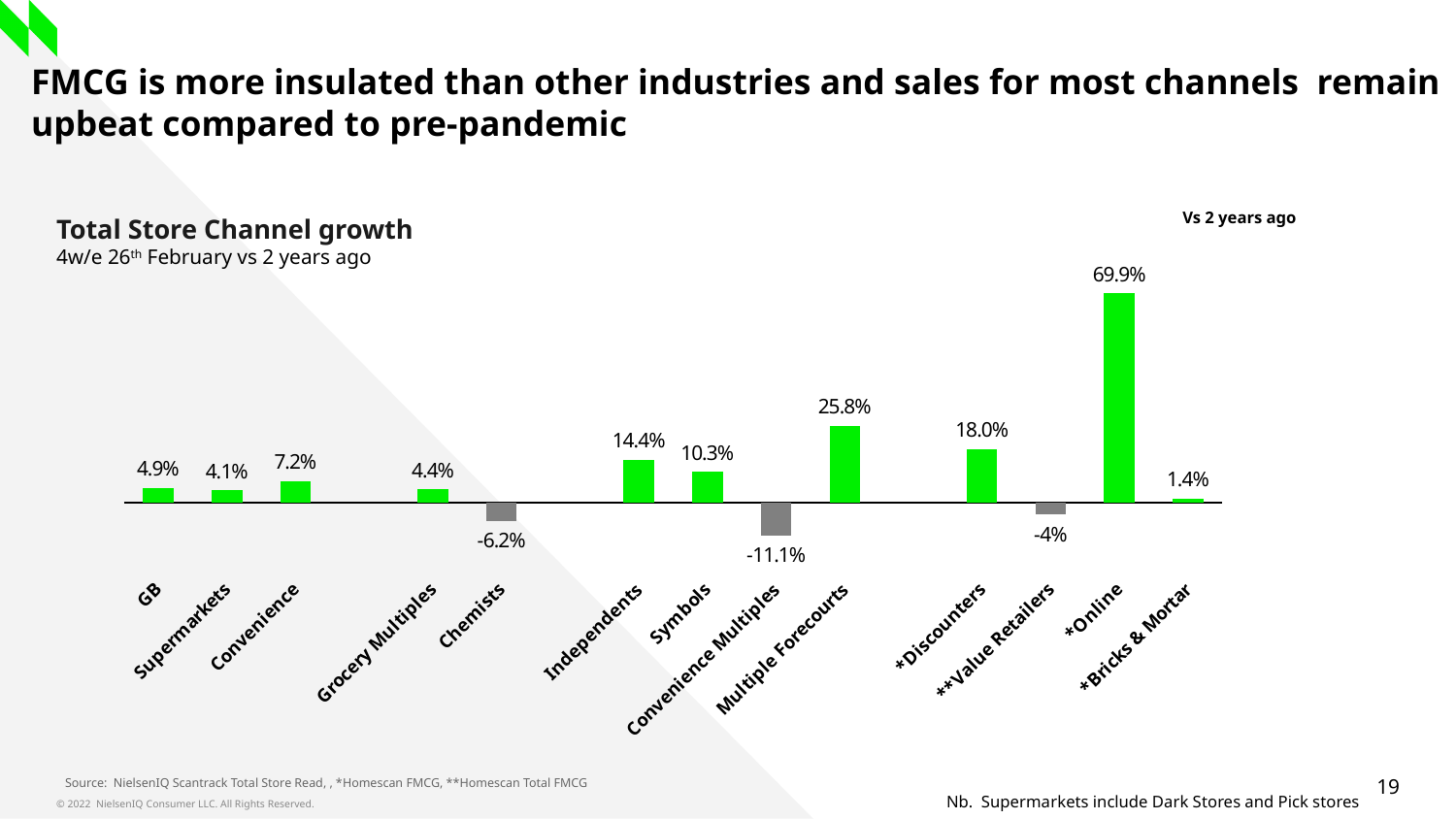
What is the growth value for Supermarkets? 4.1% How many channels are shown on the chart? 13 What is the growth value for *Online? 69.9% What colour are the bars with negative values? Grey Which channel has the lowest growth? Convenience Multiples What is the growth value for Chemists? -6.2% Which has higher growth, Symbols or Convenience? Symbols What type of chart is shown? Bar chart What is the growth value for Multiple Forecourts? 25.8% What is the difference between the growth for *Discounters and Independents? 3.6% What is the title of the chart? Total Store Channel growth Which channel has the highest growth? *Online